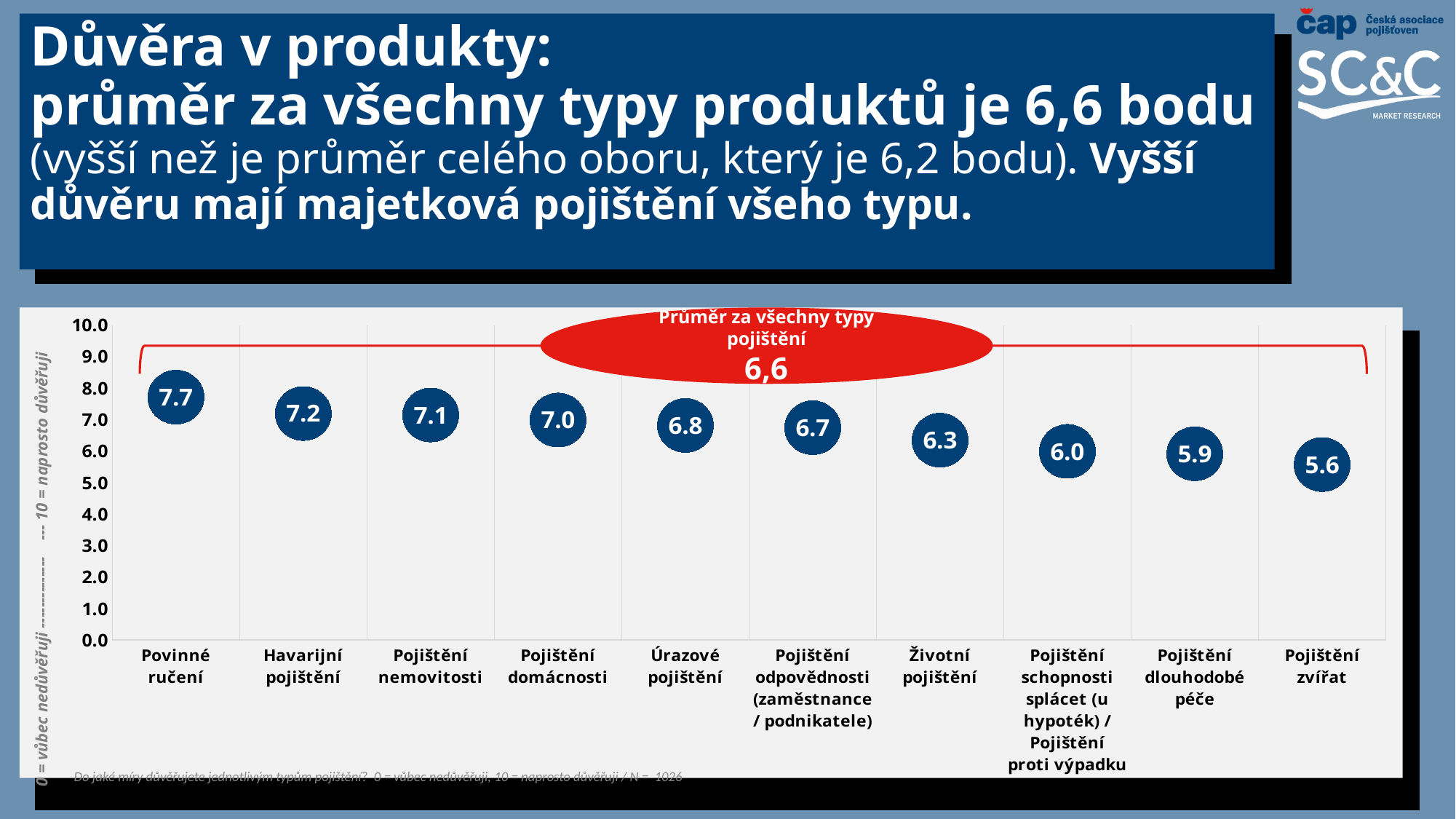
Which category has the lowest value? Pojištění zvířat What is the value for Pojištění dlouhodobé péče? 5.9 What is the value for Životní pojištění? 6.3 What is the value for Úrazové pojištění? 6.8 Which category has the highest value? Povinné ručení What is the difference between the values for Povinné ručení and Pojištění zvířat? 2.1 What is the value for Povinné ručení? 7.7 Is the value for Pojištění odpovědnosti (zaměstnance / podnikatele) greater or less than 6.0? greater How many categories are plotted on the chart? 10 Which is larger, the value for Havarijní pojištění or the value for Pojištění domácnosti? Havarijní pojištění Do the values rise or fall from left to right along the x axis? fall What average value is shown in the red oval labelled 'Průměr za všechny typy pojištění'? 6,6